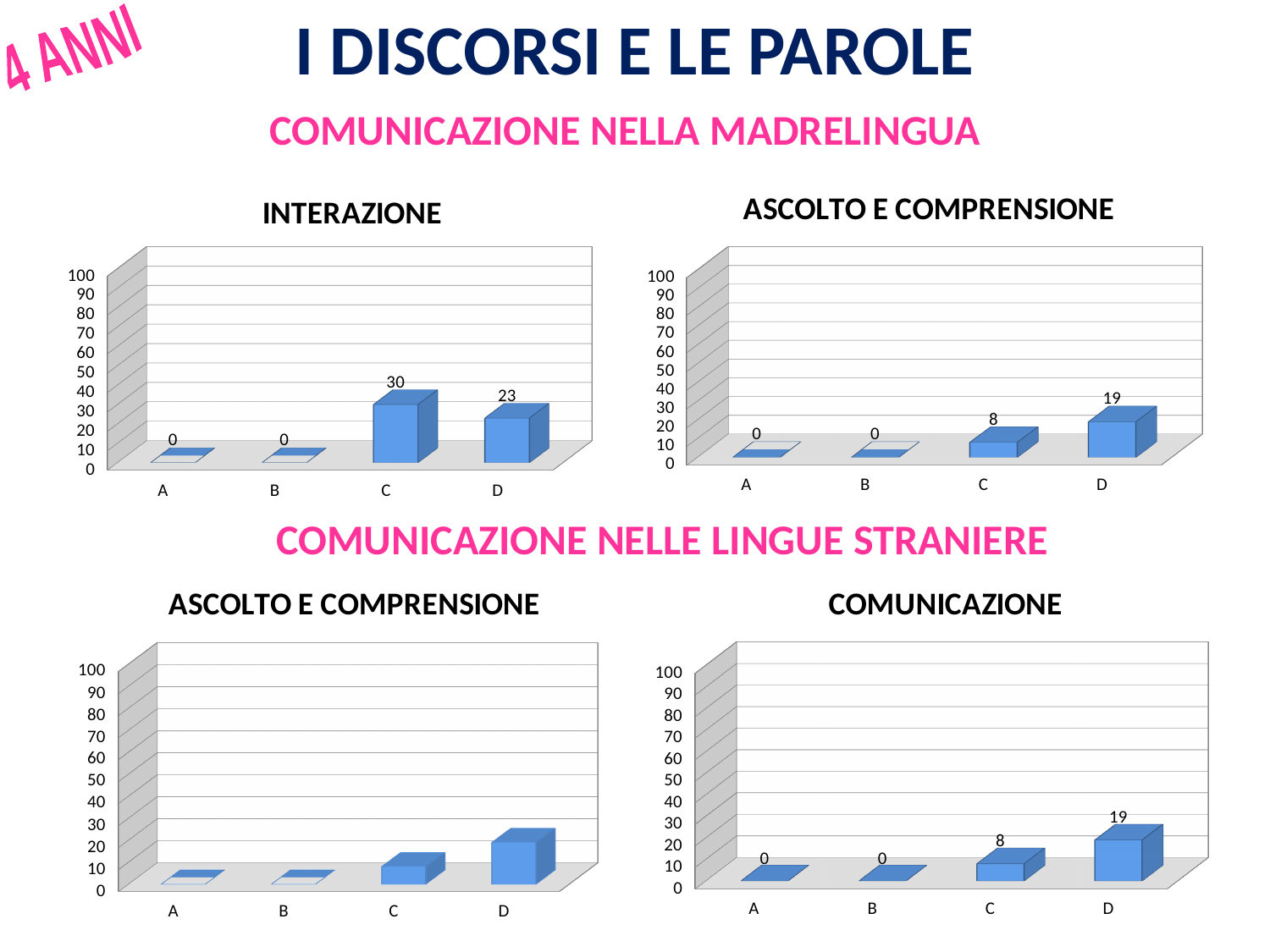
In the ASCOLTO E COMPRENSIONE chart under COMUNICAZIONE NELLE LINGUE STRANIERE (bottom left), is the value for D greater or less than 30? less How many categories are shown on the x axis of the INTERAZIONE chart (top left)? 4 In the INTERAZIONE chart (top left), what is the value for category D? 23 In the INTERAZIONE chart (top left), what is the value for category C? 30 In the ASCOLTO E COMPRENSIONE chart under COMUNICAZIONE NELLA MADRELINGUA (top right), what is the value for category D? 19 In the INTERAZIONE chart (top left), what is the difference between the values for C and D? 7 What kind of chart is the COMUNICAZIONE chart (bottom right)? bar chart In the ASCOLTO E COMPRENSIONE chart under COMUNICAZIONE NELLA MADRELINGUA (top right), what is the value for category C? 8 In the INTERAZIONE chart (top left), which category has the highest value? C In the COMUNICAZIONE chart (bottom right), what is the value for category A? 0 In the COMUNICAZIONE chart (bottom right), what is the difference between the values for D and C? 11 In the ASCOLTO E COMPRENSIONE chart under COMUNICAZIONE NELLA MADRELINGUA (top right), which is larger, the value for C or the value for D? D